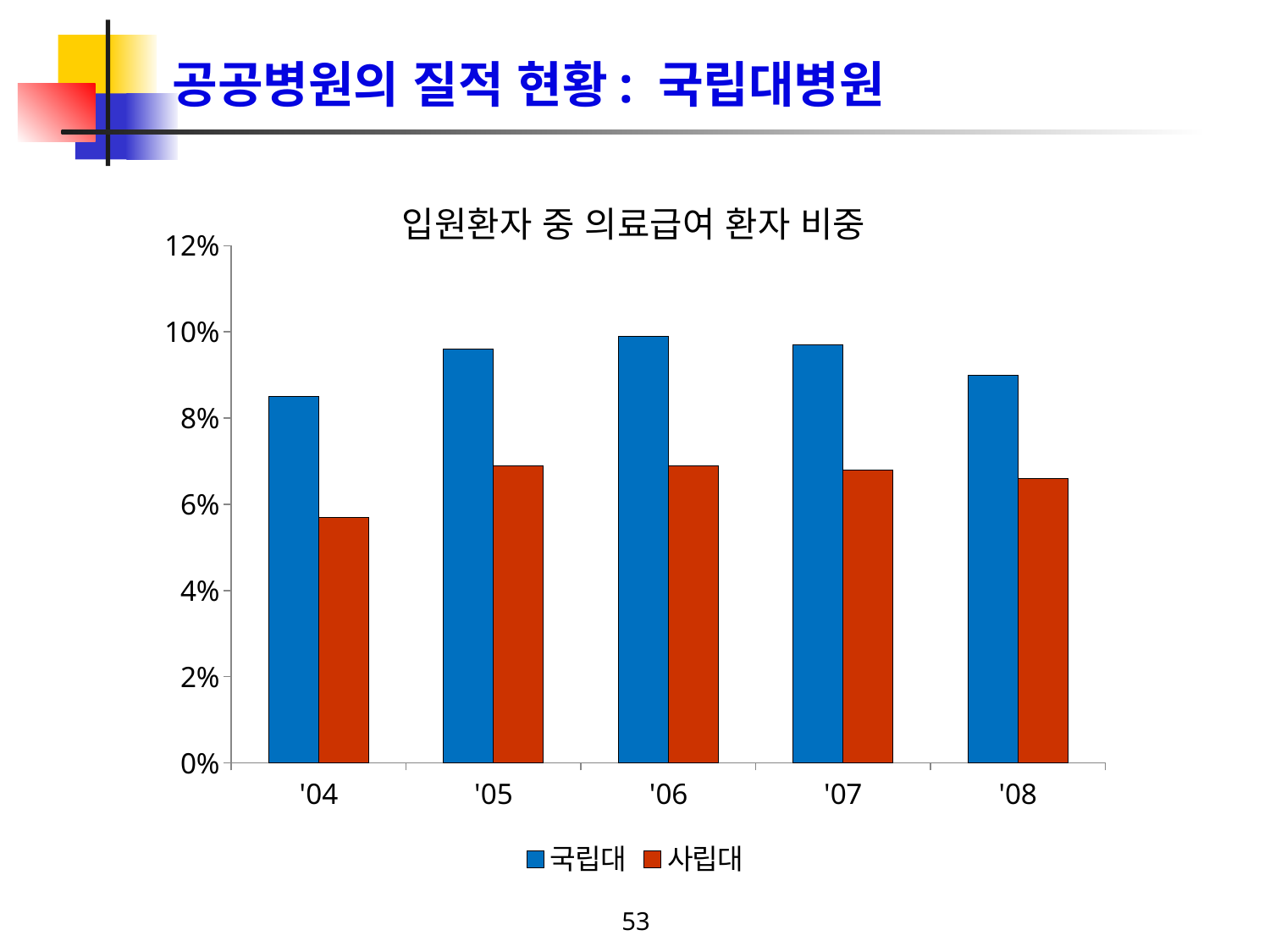
Is the value for 사립대 in '05 greater or less than 6%? greater Which series is shown in blue in the legend? 국립대 Is the value for 사립대 in '04 greater or less than 6%? less In which year is the value for 국립대 lowest? '04 How many series does the legend list? 2 Is the value for 국립대 in '04 greater or less than 8%? greater What is the title of the chart? 입원환자 중 의료급여 환자 비중 How many years are shown on the x axis of the chart? 5 In '07, which is larger, 국립대 or 사립대? 국립대 Do the values for 국립대 rise or fall from '06 to '08? fall What kind of chart is shown on the slide? bar chart